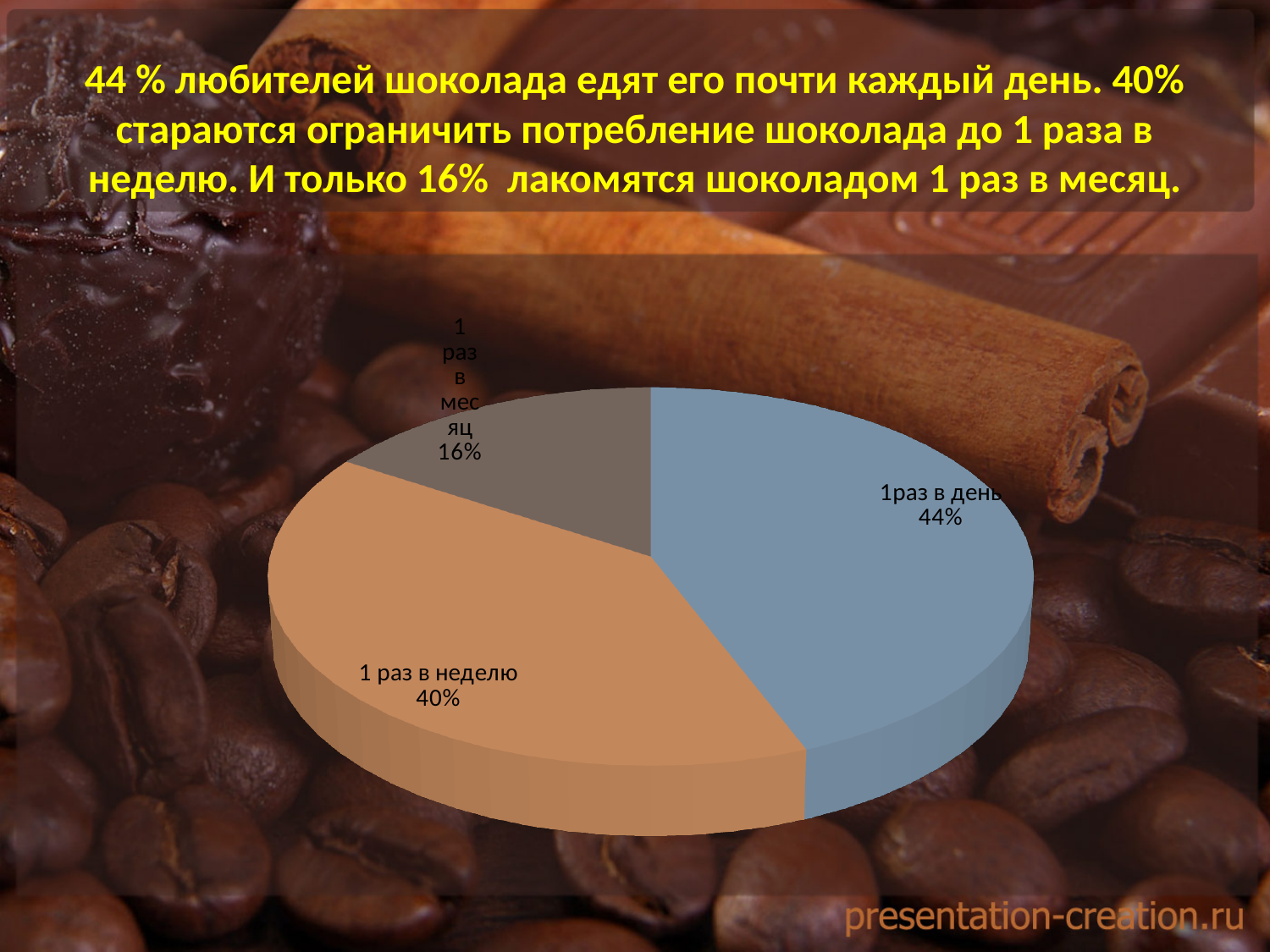
Which category has the smallest slice of the pie? 1 раз в месяц What share of the pie does the "1 раз в неделю" slice represent? 40% What is the difference in percentage points between the "1 раз в неделю" slice and the "1 раз в месяц" slice? 24 What share of the pie does the "1раз в день" slice represent? 44% What share of the pie does the "1 раз в месяц" slice represent? 16% Which category has the largest slice of the pie? 1раз в день What kind of chart is shown on the slide? pie chart What colour is the "1 раз в неделю" slice? orange What colour is the "1раз в день" slice? blue Which slice is larger: "1 раз в неделю" or "1 раз в месяц"? 1 раз в неделю What is the difference in percentage points between the "1раз в день" slice and the "1 раз в месяц" slice? 28 How many slices does the pie chart have? 3